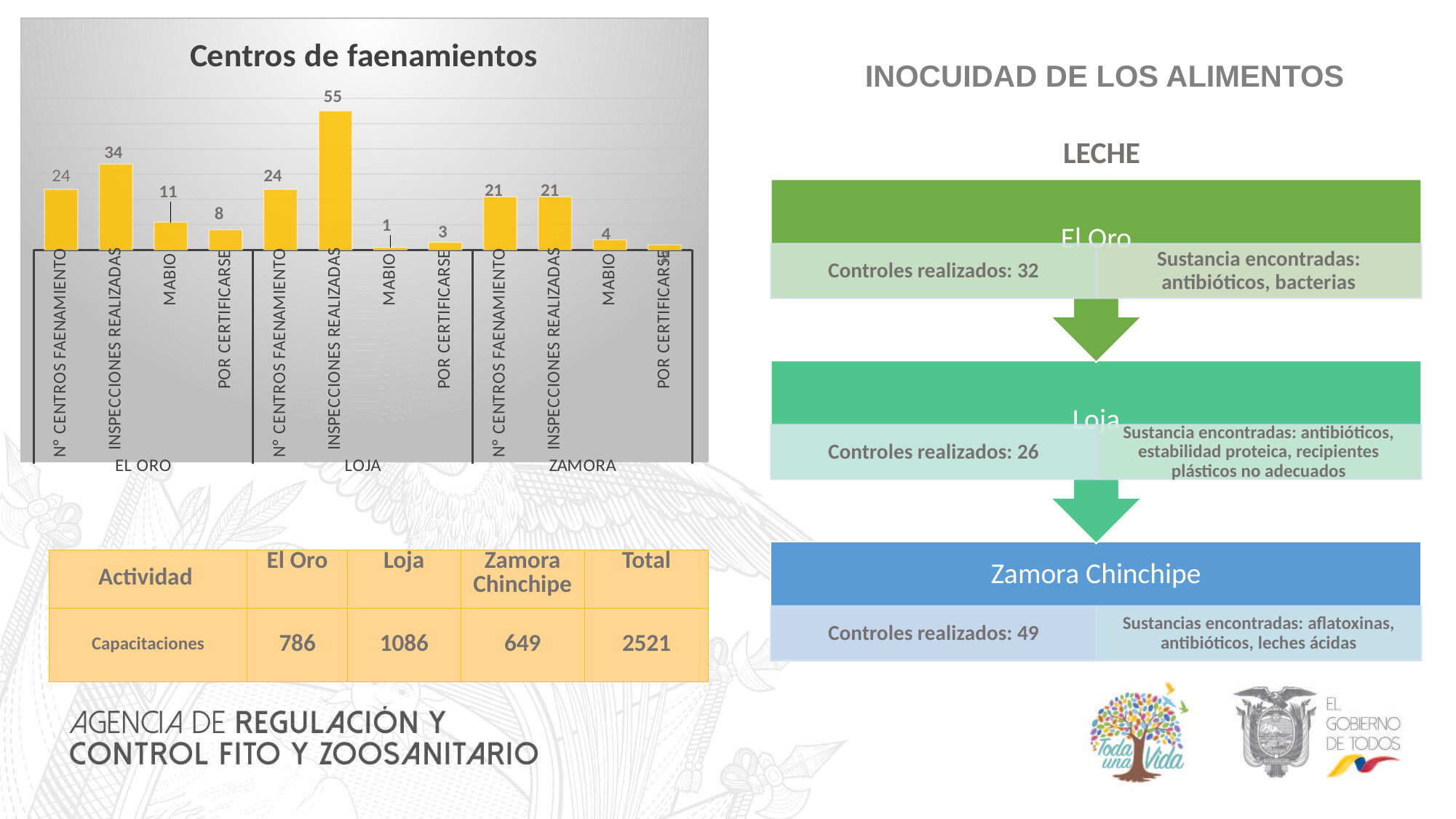
What is the difference between inspecciones realizadas in LOJA and in EL ORO? 21 What is the value for MABIO in EL ORO? 11 What is the title of the chart? Centros de faenamientos How many inspecciones realizadas are shown for LOJA? 55 Which bar has the lowest labelled value in the chart? MABIO in LOJA How many province groups are shown along the x axis? 3 How many N° CENTROS FAENAMIENTO are shown for ZAMORA? 21 What is the value for POR CERTIFICARSE in LOJA? 3 What is the difference between N° CENTROS FAENAMIENTO in EL ORO and in ZAMORA? 3 Which is larger: MABIO in EL ORO or MABIO in ZAMORA? MABIO in EL ORO Which bar has the highest value in the chart? INSPECCIONES REALIZADAS in LOJA What type of chart is shown on the slide? bar chart